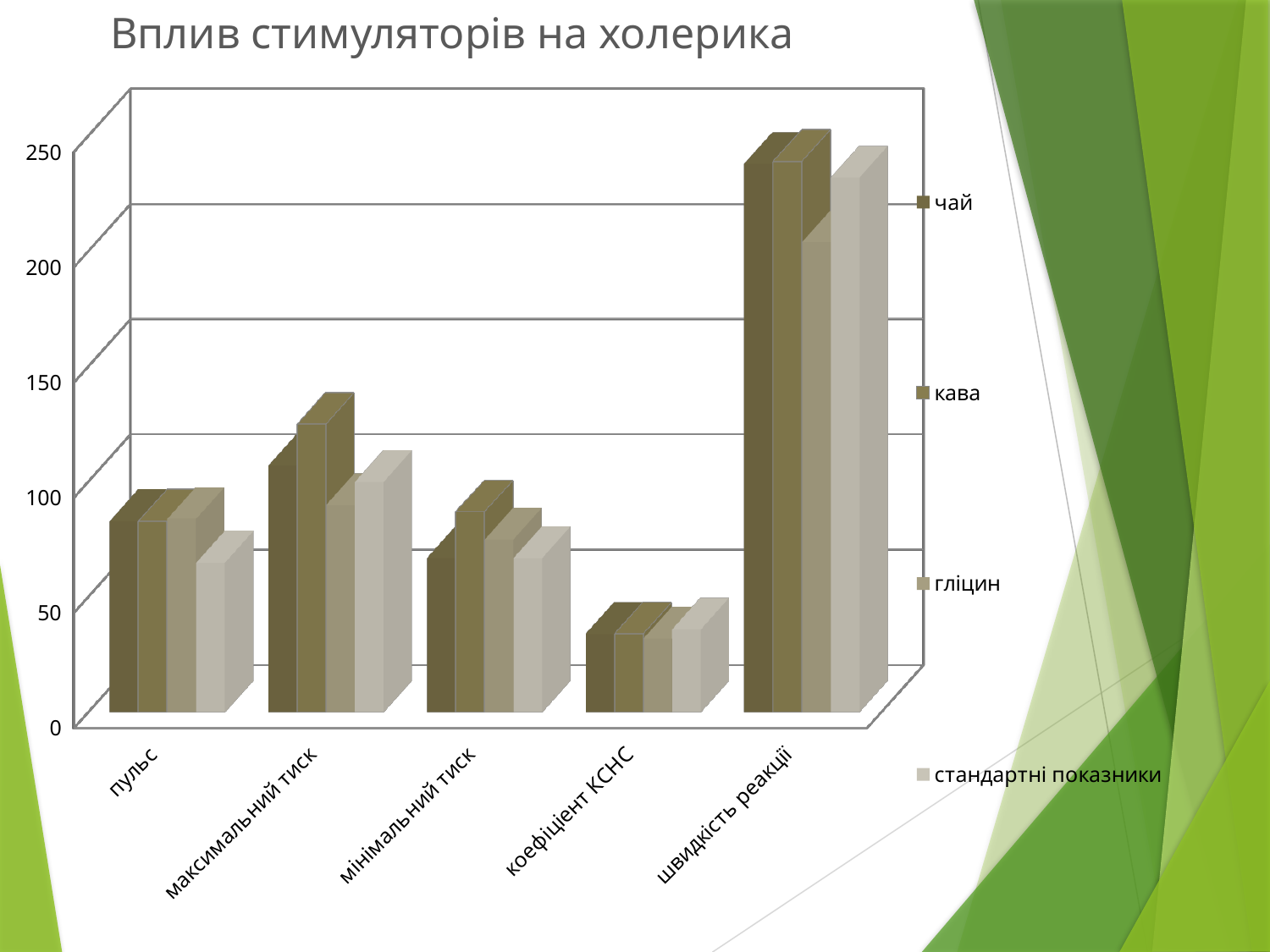
Which series is listed last in the chart's legend? стандартні показники Which is larger for the чай series: the value for швидкість реакції or the value for пульс? швидкість реакції Is the value for чай in the мінімальний тиск category greater or less than 150? less How many series does the chart's legend list? 4 What kind of chart is shown on the slide? bar chart Which category has the highest values in the chart? швидкість реакції Is the value for стандартні показники in the пульс category greater or less than 100? less What is the title of the chart? Вплив стимуляторів на холерика Which category has the lowest values in the chart? коефіцієнт КСНС How many categories are shown on the x axis of the chart? 5 Is the value for чай in the коефіцієнт КСНС category greater or less than 50? less